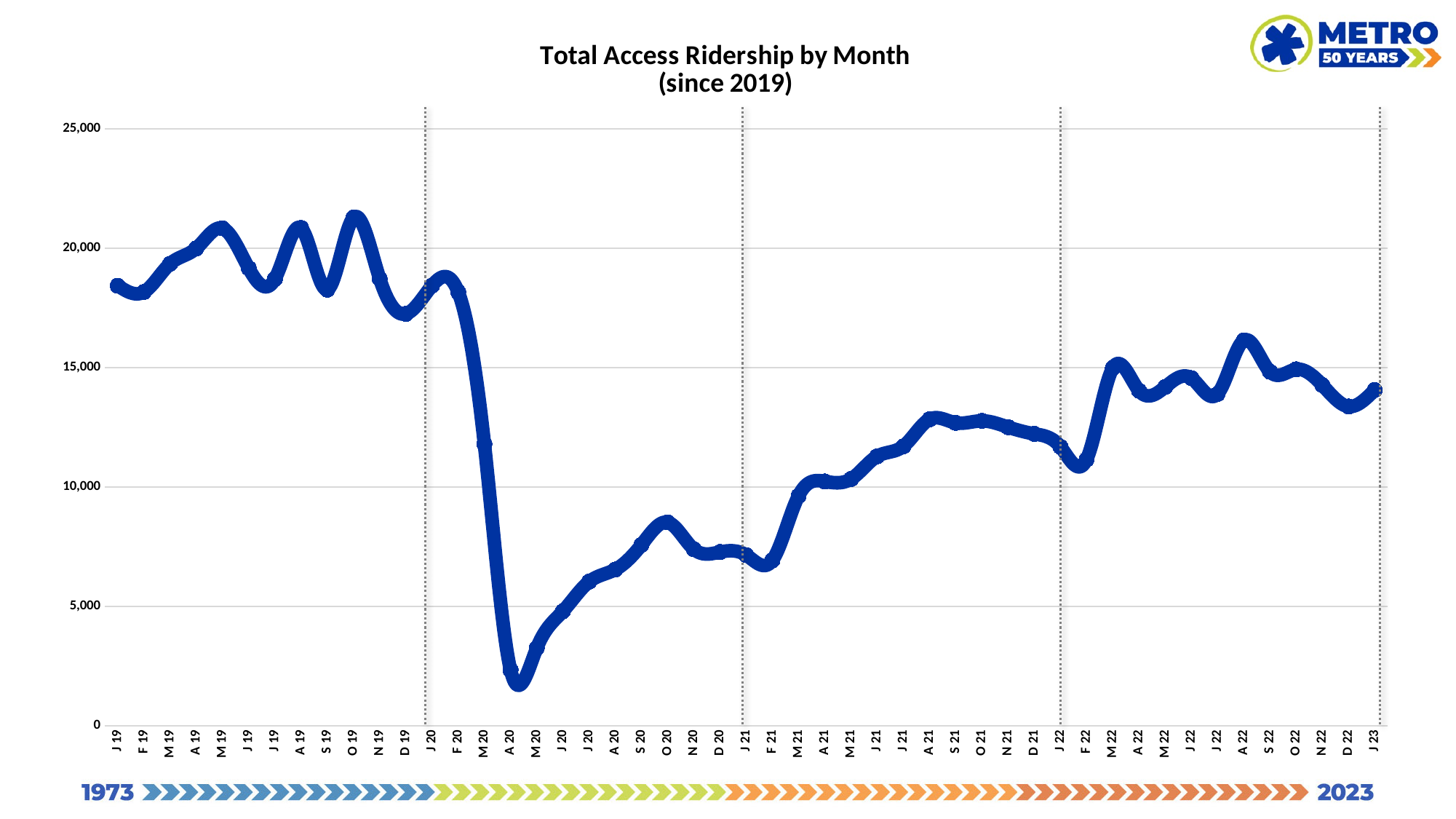
How many monthly data points are plotted on the chart? 49 Is the value for O 19 greater or less than 20,000? greater What kind of chart is shown on the slide? line chart Is the value for J 23 greater or less than 15,000? less Which month has the highest ridership on the chart? O 19 Is the value for F 21 greater or less than 10,000? less What is the title of the chart? Total Access Ridership by Month (since 2019) Does ridership rise or fall between F 20 and A 20? fall